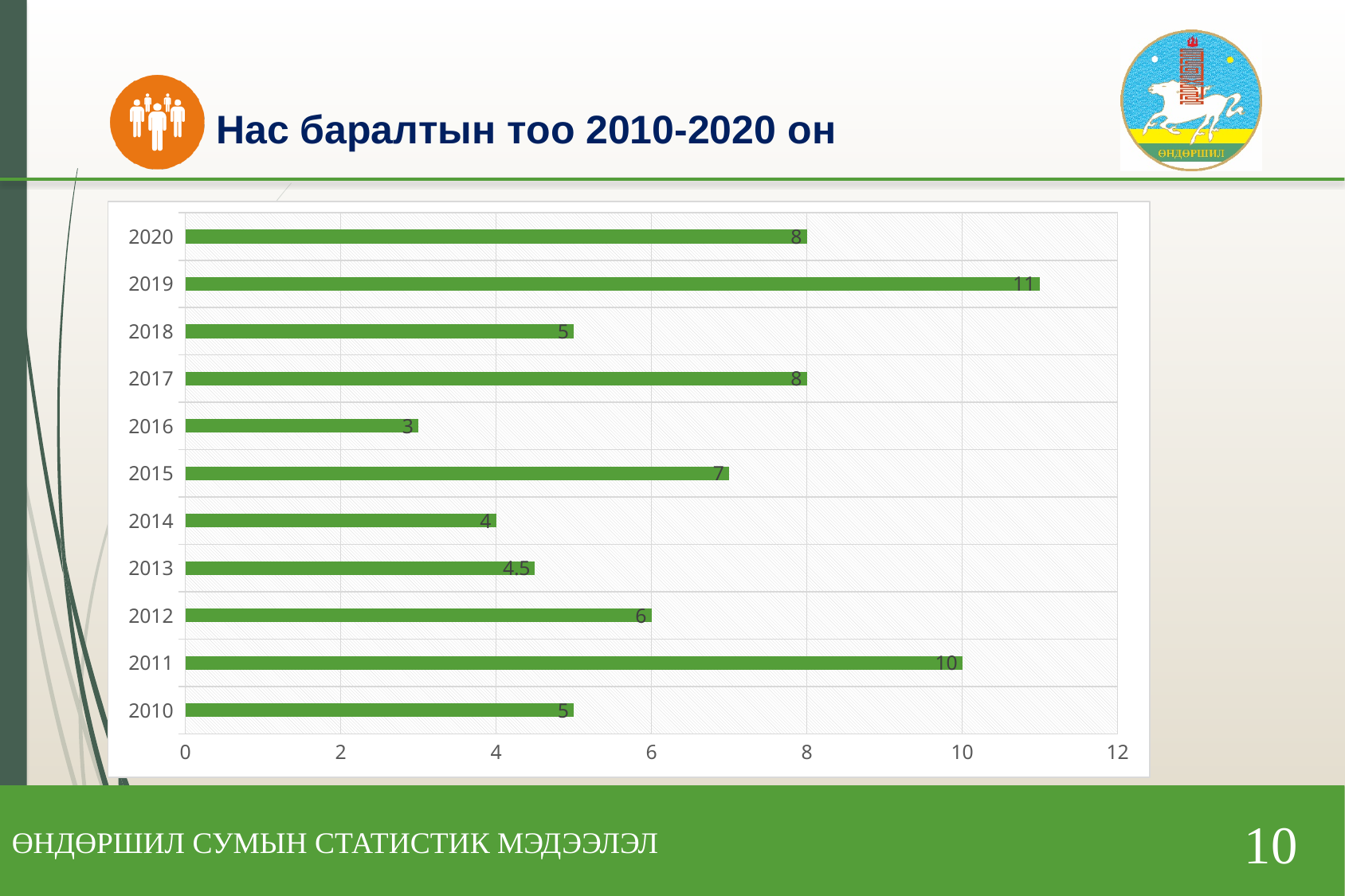
What is the difference between the values for 2020 and 2014? 4 How many years are shown on the chart? 11 Which year has the highest value? 2019 What is the value for 2016? 3 What is the title of the slide? Нас баралтын тоо 2010-2020 он What kind of chart is shown on the slide? bar chart What is the value for 2013? 4.5 What is the difference between the values for 2019 and 2018? 6 Is the value for 2015 greater or less than 6? greater What is the value for 2019? 11 Which year has the lowest value? 2016 Which is larger, the value for 2011 or the value for 2012? 2011